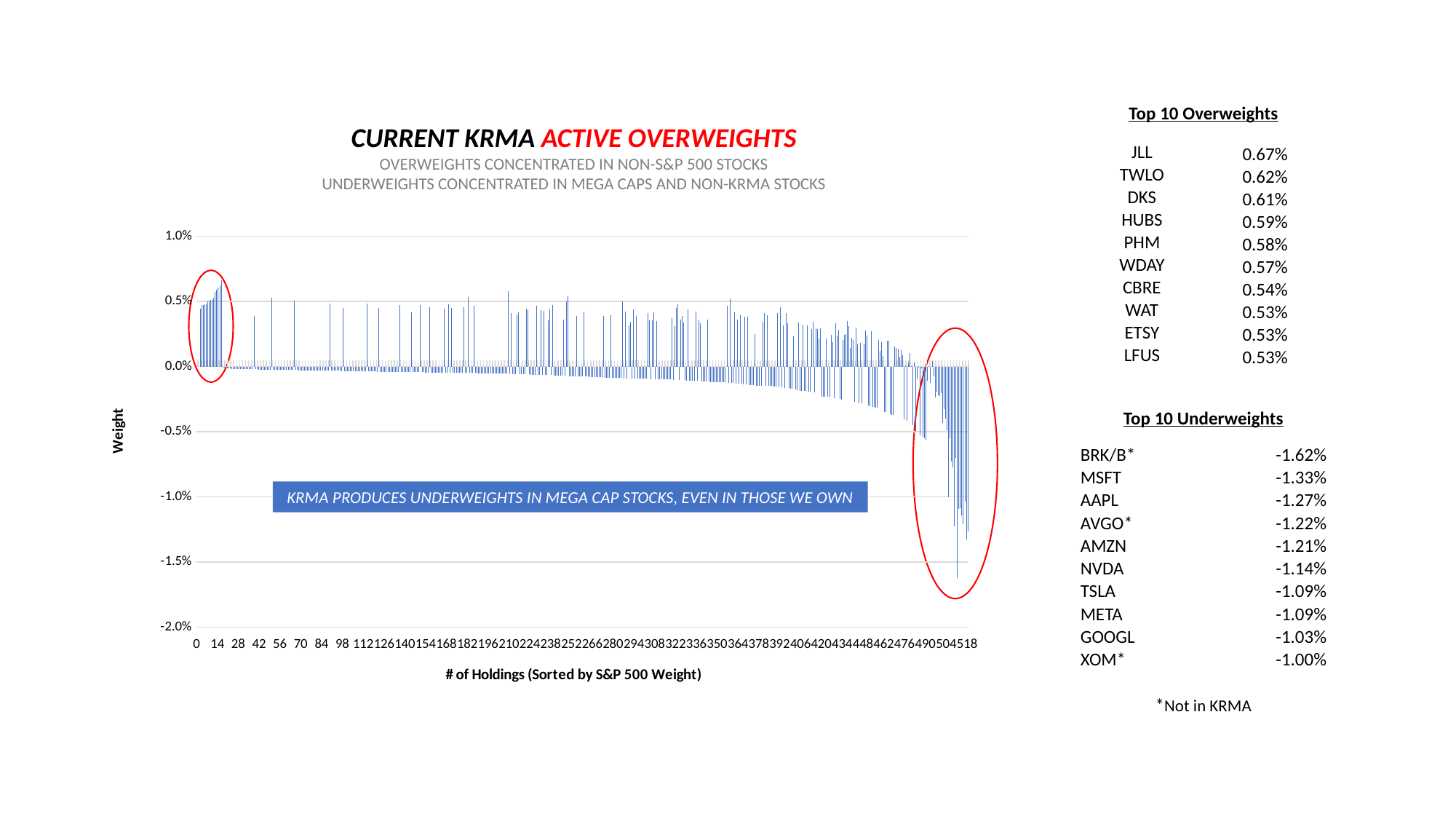
According to the Top 10 Overweights table, what is the weight for JLL? 0.67% What is the title of the chart? CURRENT KRMA ACTIVE OVERWEIGHTS According to the Top 10 Underweights table, what is the difference between the MSFT and AAPL underweights? 0.06% According to the Top 10 Underweights table, which holding has the largest underweight? BRK/B Is the lowest bar on the chart greater or less than -1.5%? less What is the lowest value shown on the chart's y axis? -2.0% Is the tallest positive bar on the chart greater or less than 0.5%? greater Do the bar values generally rise or fall moving from left to right along the x axis? fall What kind of chart is shown on the slide? Bar chart What is the highest value shown on the chart's y axis? 1.0% According to the Top 10 Overweights table, which is larger, the weight for TWLO or the weight for DKS? TWLO